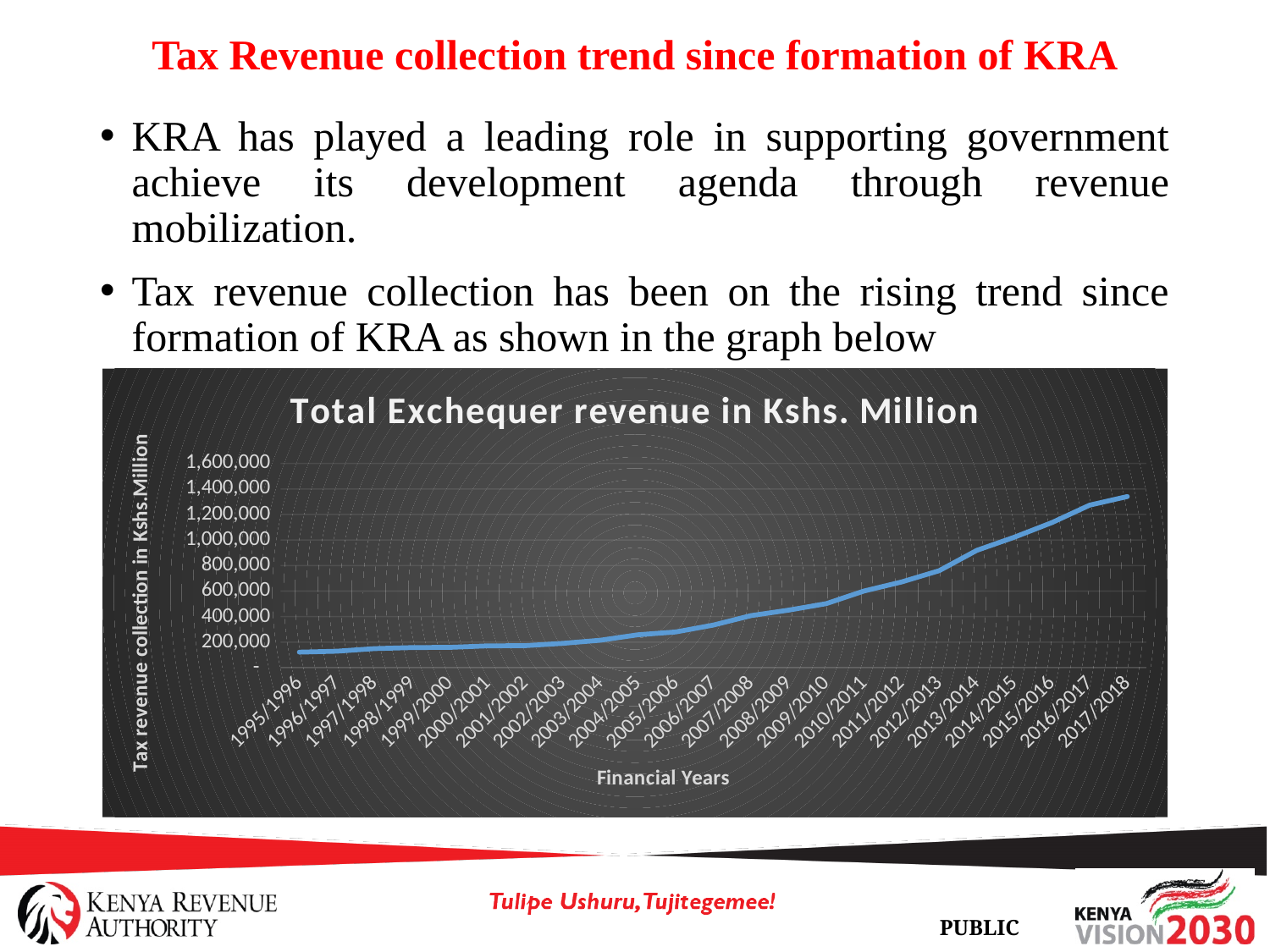
Is the value for 2012/2013 greater or less than 600,000? greater Is the value for 2005/2006 greater or less than 400,000? less Is the value for 1995/1996 greater or less than 200,000? less Which financial year has the highest total exchequer revenue in the chart? 2017/2018 What is the title of the chart? Total Exchequer revenue in Kshs. Million Which financial year has the larger total exchequer revenue, 2000/2001 or 2010/2011? 2010/2011 Which financial year has the lowest total exchequer revenue in the chart? 1995/1996 What is the label of the x axis of the chart? Financial Years What kind of chart is shown on the slide? line chart Do the values in the chart rise or fall from 1995/1996 to 2017/2018? rise How many financial years are plotted on the x axis of the chart? 23